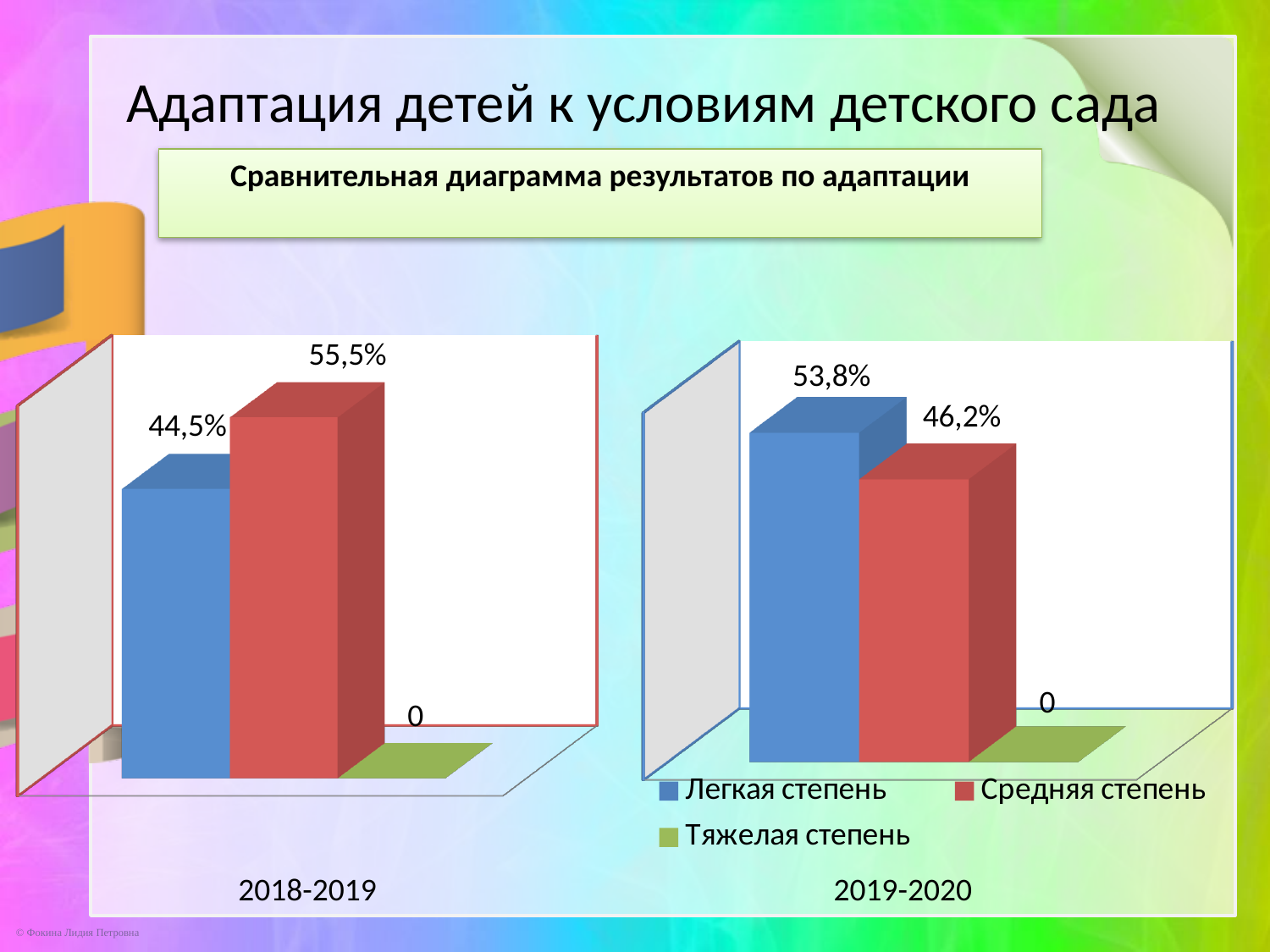
How many series does the legend list? 3 In the 2019-2020 chart, what is the difference between Легкая степень and Средняя степень? 7,6% In the 2018-2019 chart, what is the value for Легкая степень? 44,5% In the 2019-2020 chart, what is the value for Легкая степень? 53,8% In the 2018-2019 chart, what is the value for Средняя степень? 55,5% In the 2019-2020 chart, what is the value for Средняя степень? 46,2% In the 2019-2020 chart, which series has the highest value? Легкая степень In the 2018-2019 chart, which series has the lowest value? Тяжелая степень In the 2018-2019 chart, what is the difference between Средняя степень and Легкая степень? 11% In the 2019-2020 chart, what is the value for Тяжелая степень? 0 In the 2018-2019 chart, which series has the highest value? Средняя степень In the 2019-2020 chart, which is larger: Легкая степень or Средняя степень? Легкая степень